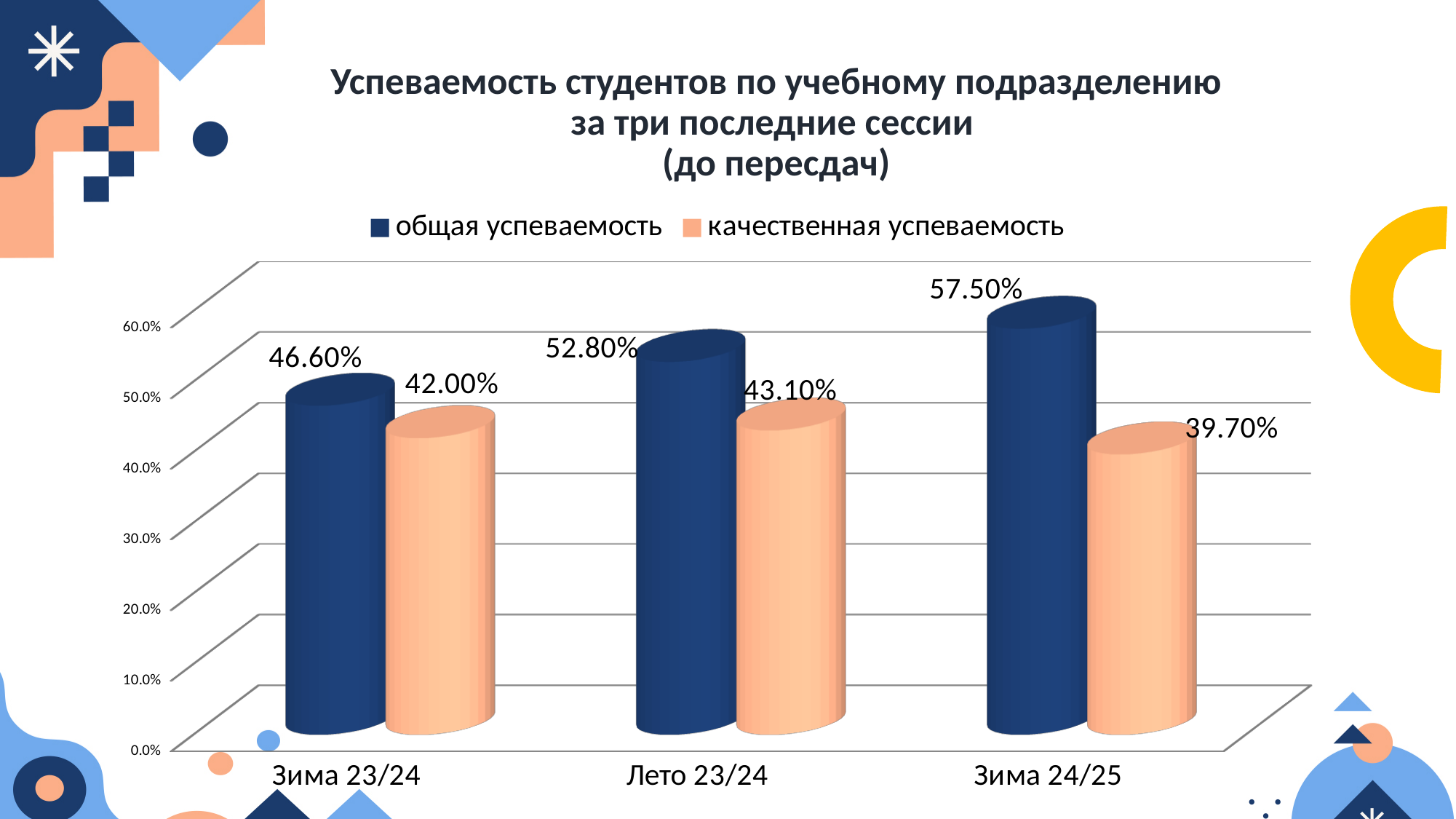
What is the value of общая успеваемость for Зима 23/24? 46.60% Which is larger for Лето 23/24: общая успеваемость or качественная успеваемость? общая успеваемость Does общая успеваемость rise or fall across the three sessions from Зима 23/24 to Зима 24/25? rise What is the value of общая успеваемость for Зима 24/25? 57.50% What kind of chart is shown on the slide? bar chart What is the difference between общая успеваемость and качественная успеваемость for Зима 24/25? 17.80% What is the value of качественная успеваемость for Зима 24/25? 39.70% How many series does the legend list? 2 In which session is качественная успеваемость the lowest? Зима 24/25 What is the value of качественная успеваемость for Лето 23/24? 43.10% How many sessions (categories) are shown on the x axis? 3 In which session is общая успеваемость the highest? Зима 24/25